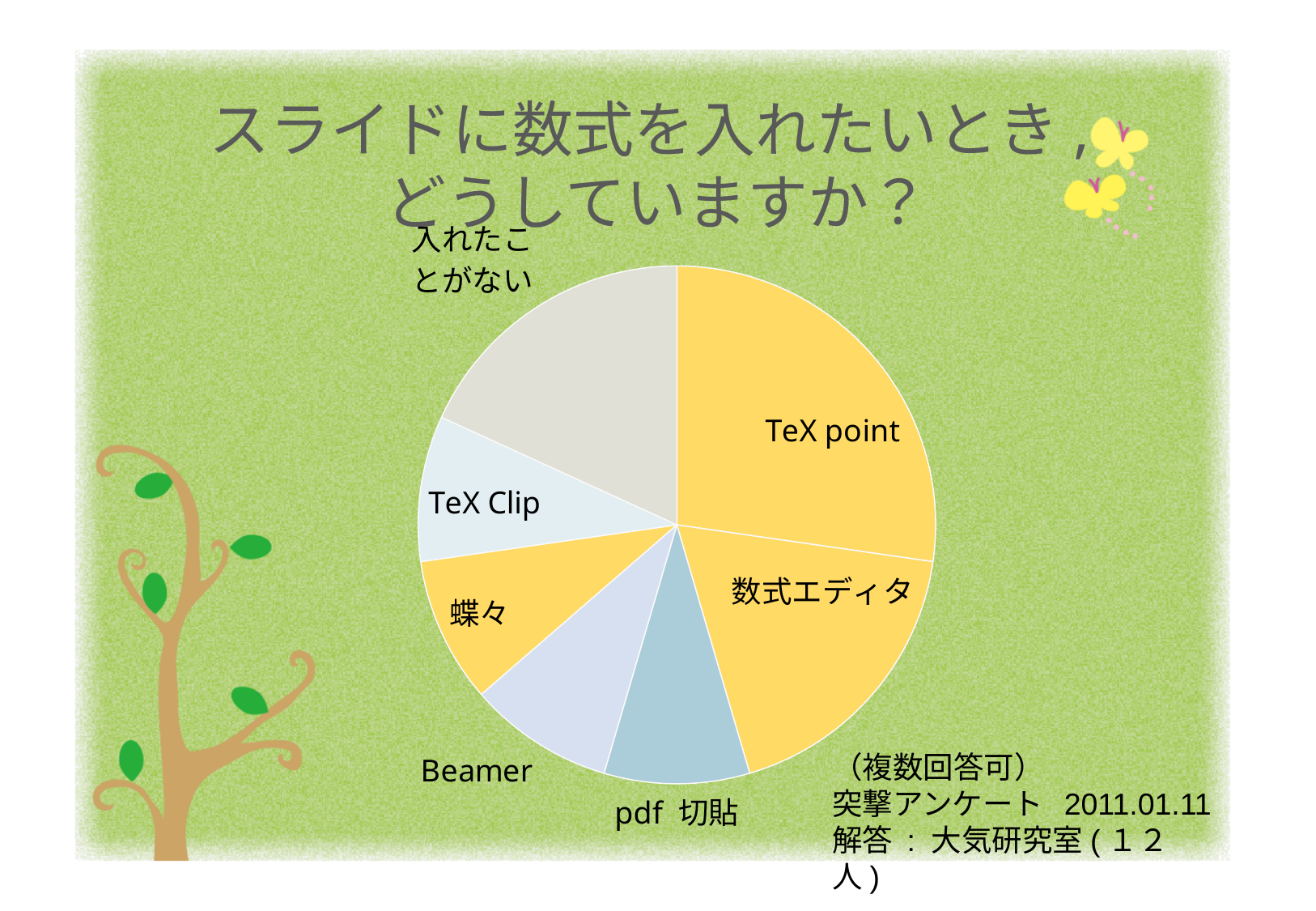
Which slice is larger, TeX point or 入れたことがない? TeX point Which category has the largest slice of the pie chart? TeX point Which slice is larger, 数式エディタ or Beamer? 数式エディタ How many respondents does the note below the pie chart say answered the survey? 12人 How many slices does the pie chart have? 7 Which slice is larger, 入れたことがない or pdf 切貼? 入れたことがない What is the title of the slide containing the pie chart? スライドに数式を入れたいとき, どうしていますか？ What kind of chart is shown on the slide? pie chart